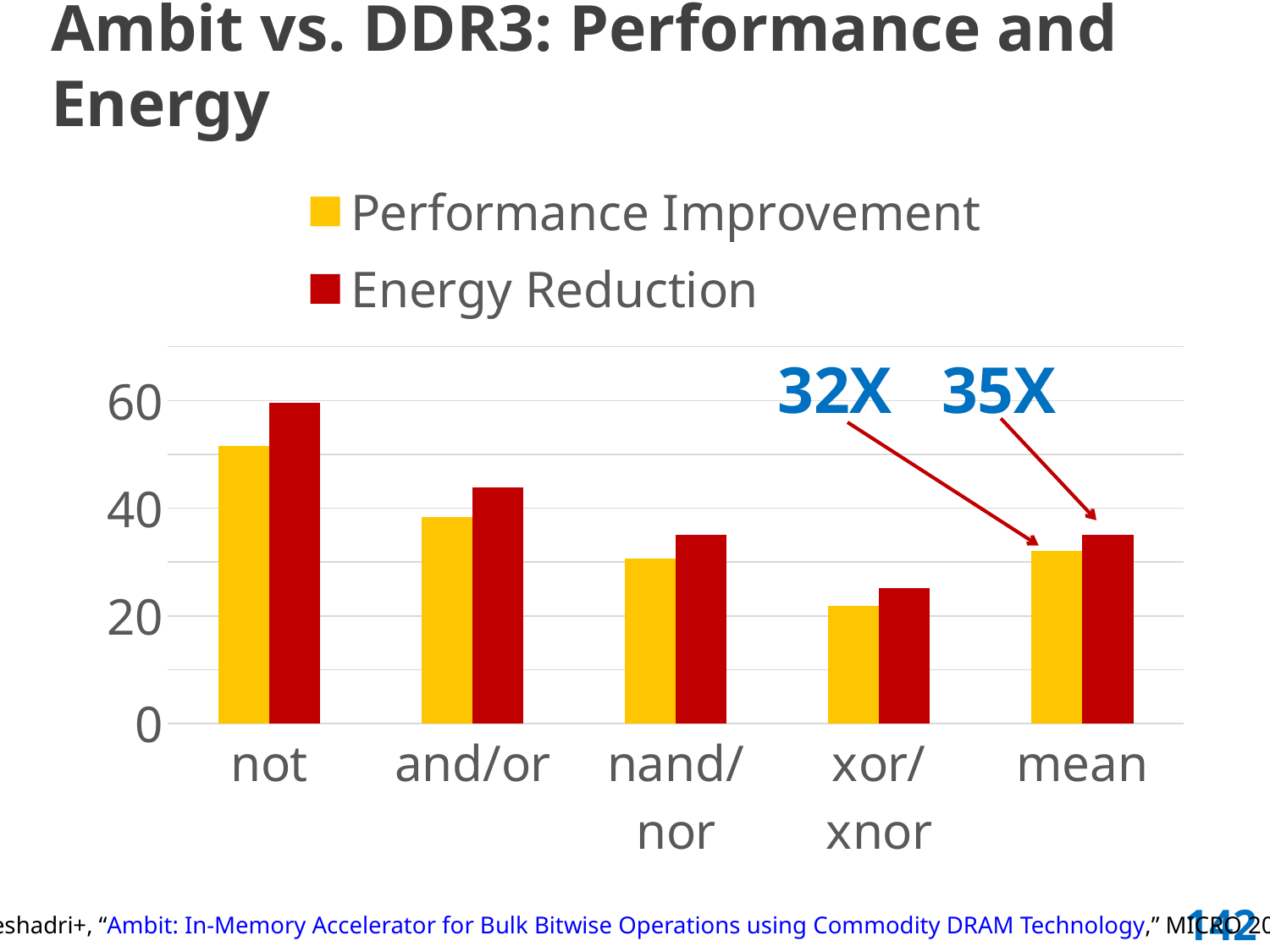
Which category has the lowest Performance Improvement? xor/xnor How many categories are shown on the x axis? 5 What kind of chart is shown on the slide? bar chart Is the Energy Reduction value for not greater or less than 40? greater Which colour represents Energy Reduction in the legend? red Is the Performance Improvement value for nand/nor greater or less than 40? less For xor/xnor, which is larger: Performance Improvement or Energy Reduction? Energy Reduction How many series does the legend list? 2 Which category has the highest Energy Reduction? not What is the Energy Reduction value for mean, as annotated on the chart? 35X What is the difference between the annotated Energy Reduction and Performance Improvement values for mean? 3X What is the Performance Improvement value for mean, as annotated on the chart? 32X